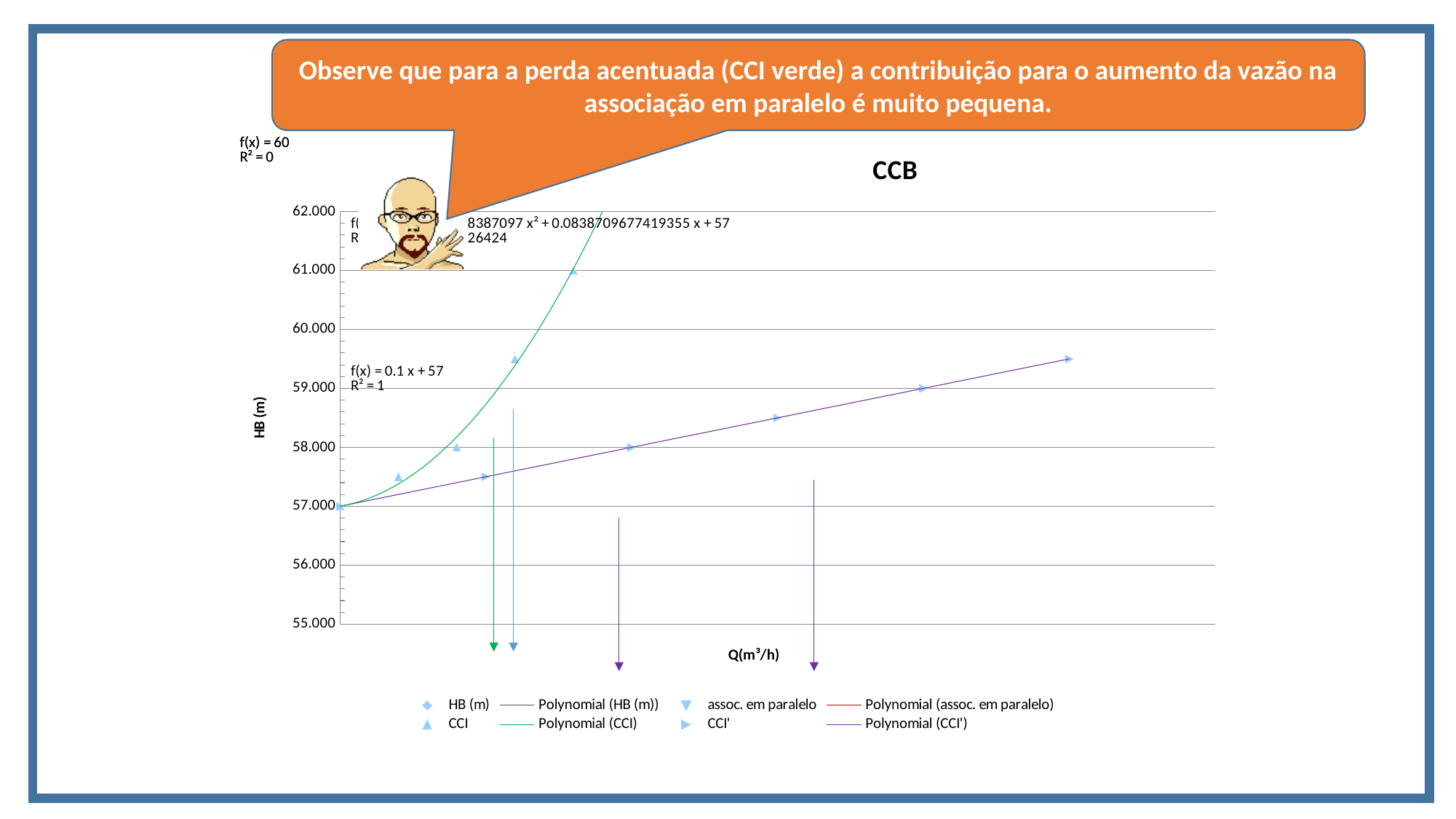
Which series reaches a higher HB value on the chart, CCI or CCI'? CCI Is the highest plotted CCI' value greater or less than 60.000? less What is the label of the vertical axis? HB (m) Is the highest plotted CCI value greater or less than 60.000? greater What is the R² value shown for the trendline f(x) = 0.1 x + 57? 1 What is the title of the chart? CCB What is the R² value shown for the trendline f(x) = 60? 0 Do the CCI values rise or fall as Q increases along the x axis? rise What kind of chart is shown on the slide? scatter chart How many entries does the chart legend list? 8 Do the CCI' values rise or fall as Q increases along the x axis? rise Is the lowest plotted CCI' value greater or less than 58.000? less